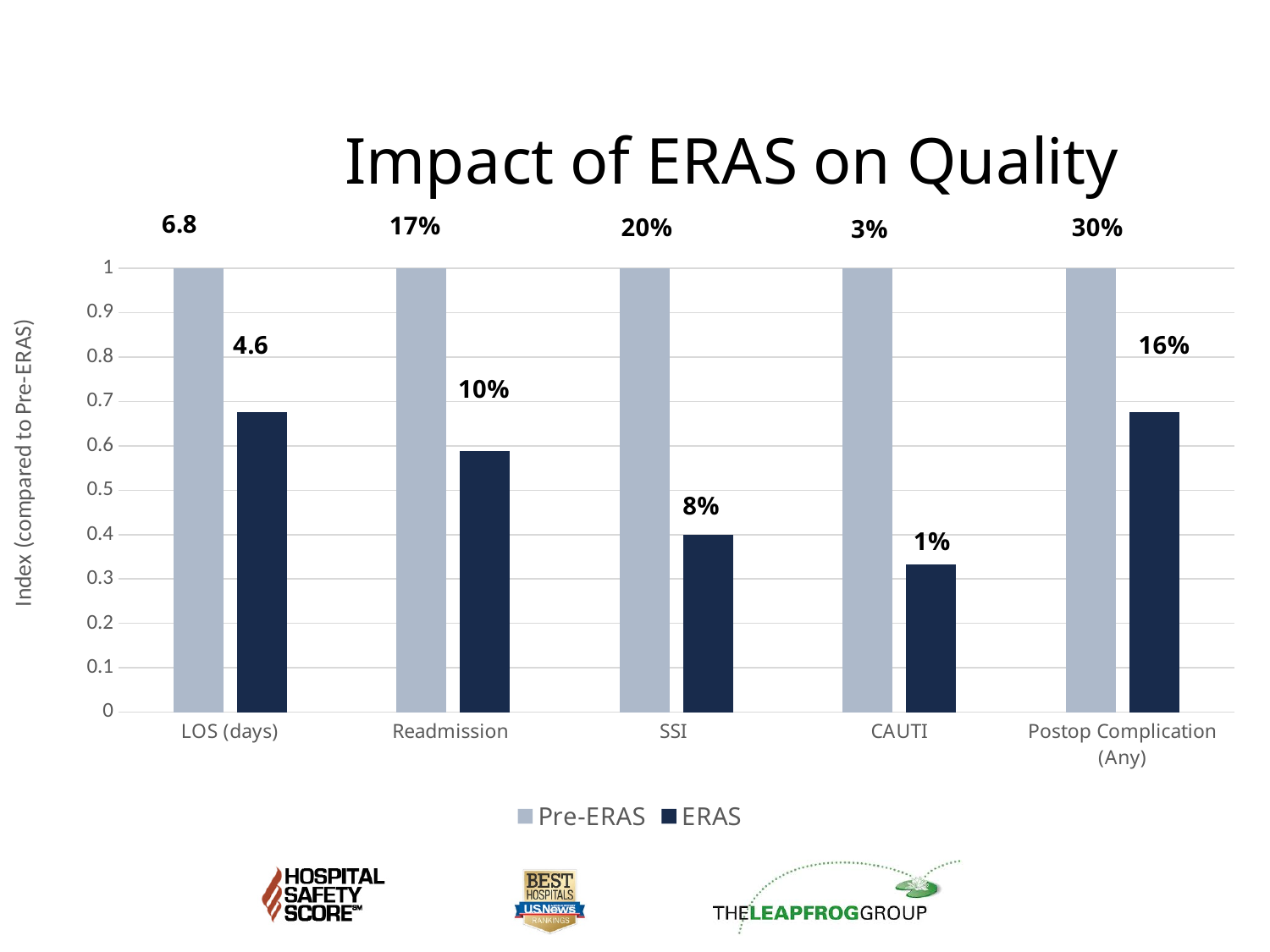
What is the difference between the Pre-ERAS and ERAS values labelled for Postop Complication (Any)? 14% What kind of chart is shown on the slide? Bar chart What is the ERAS value labelled for Readmission? 10% How many series does the legend list? 2 What is the difference between the Pre-ERAS and ERAS values labelled for LOS (days)? 2.2 What is the Pre-ERAS value labelled for Postop Complication (Any)? 30% Is the ERAS index bar for CAUTI greater or less than 0.4? less Which category has the lowest ERAS index bar? CAUTI What is the ERAS value labelled for CAUTI? 1% How many categories are shown on the x axis? 5 Is the ERAS index bar for Readmission greater or less than 0.5? greater What is the Pre-ERAS value labelled for LOS (days)? 6.8